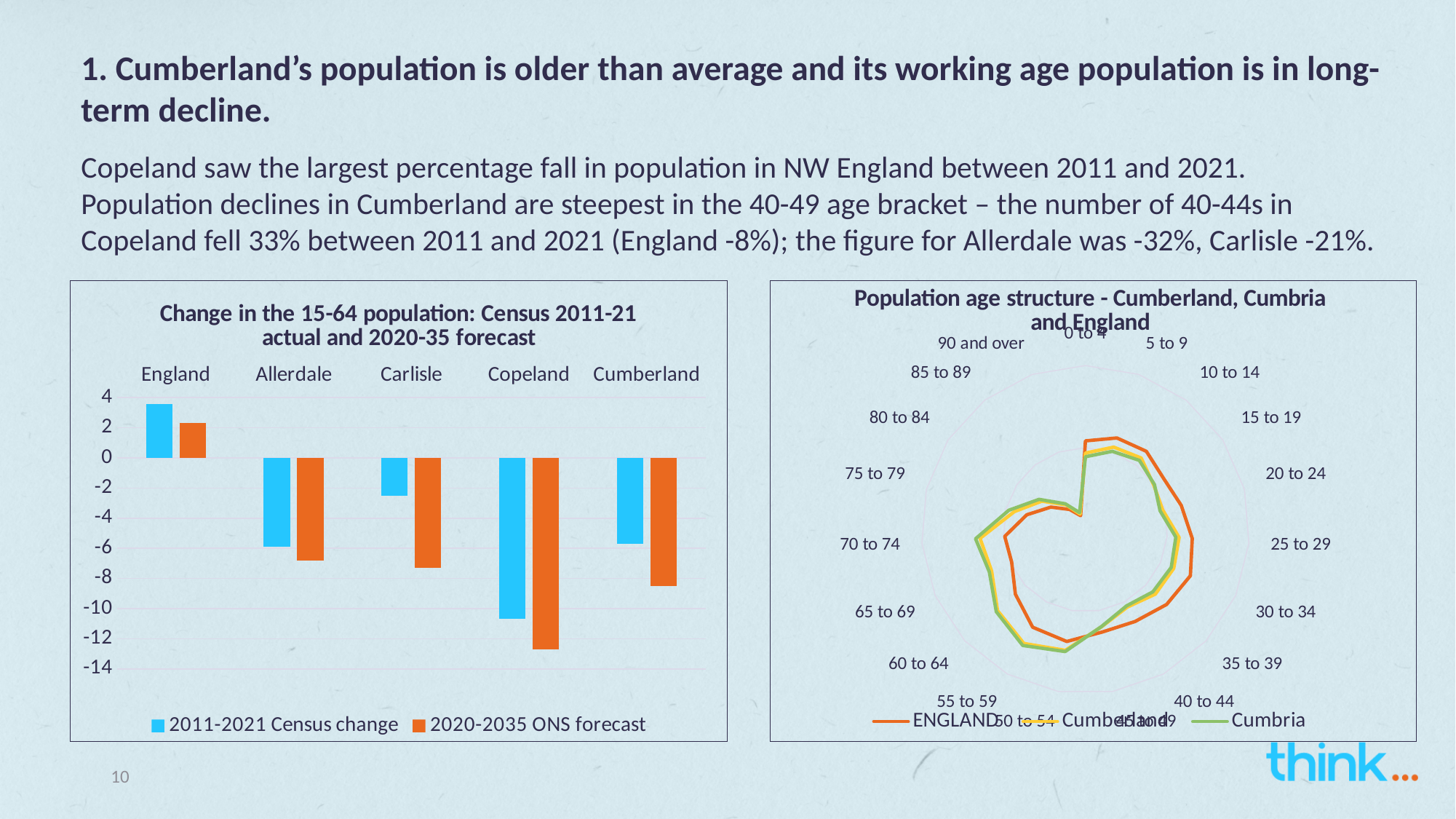
In the right chart, how many series does the legend list? 3 In the left chart, how many series does the legend list? 2 What kind of chart is the right chart, 'Population age structure - Cumberland, Cumbria and England'? Radar chart In the left chart, is the 2020-2035 ONS forecast for Copeland greater or less than -12? less In the left chart, how many areas (categories) are shown on the x axis? 5 In the left chart, which area has the highest 2011-2021 Census change? England In the left chart, which area has the lowest 2011-2021 Census change? Copeland In the left chart, is the 2011-2021 Census change for Carlisle greater or less than -4? greater In the right chart, what are the three series named in the legend? ENGLAND, Cumberland, Cumbria In the left chart, which is larger: the 2011-2021 Census change for Allerdale or for Carlisle? Carlisle What kind of chart is the left chart, 'Change in the 15-64 population: Census 2011-21 actual and 2020-35 forecast'? Bar chart In the left chart, which area has the lowest 2020-2035 ONS forecast? Copeland